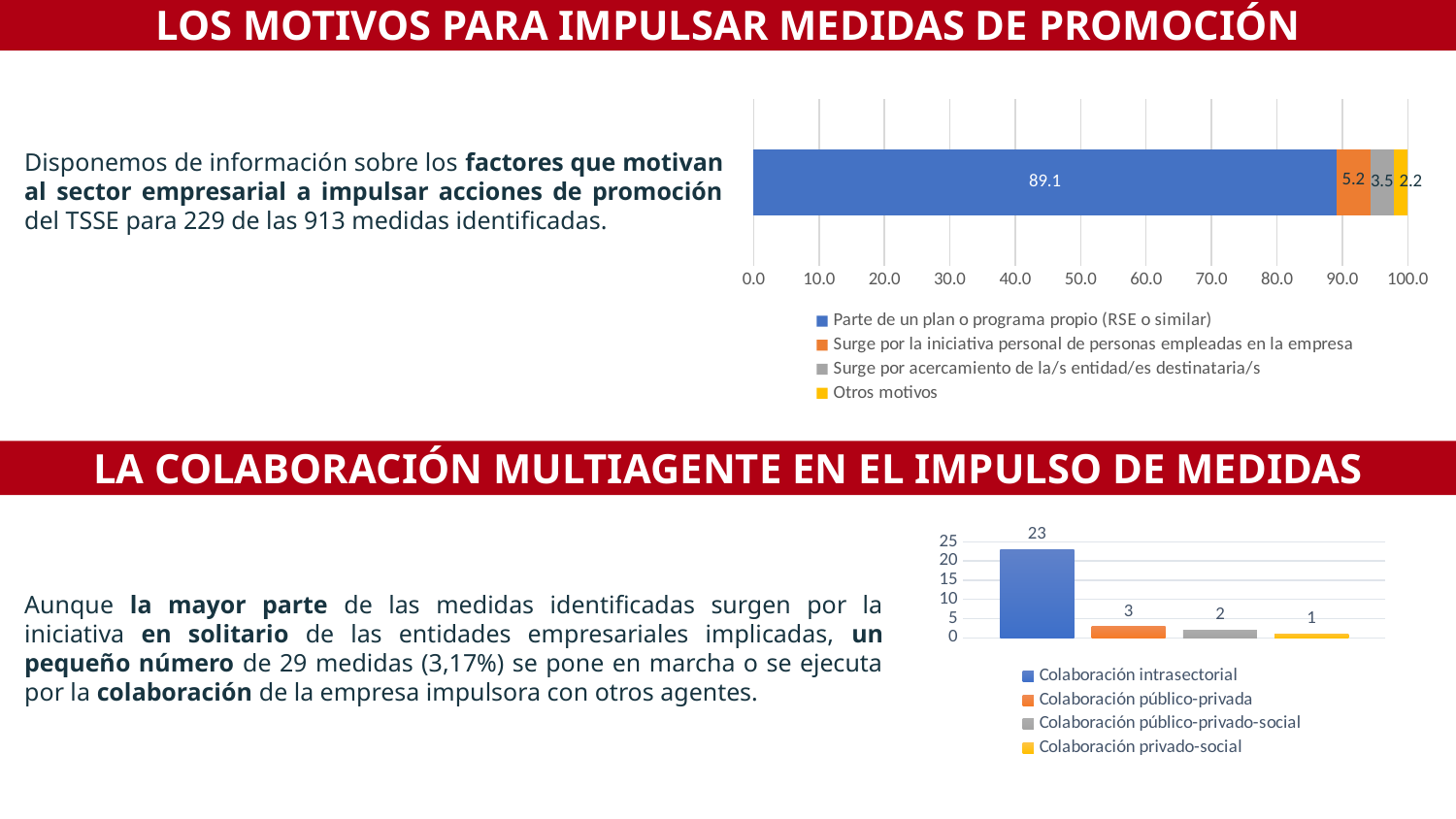
In the bottom chart, which is larger: 'Colaboración público-privada' or 'Colaboración público-privado-social'? Colaboración público-privada In the top chart, what is the value for 'Surge por la iniciativa personal de personas empleadas en la empresa'? 5.2 In the top chart, what is the difference between 'Surge por la iniciativa personal de personas empleadas en la empresa' and 'Surge por acercamiento de la/s entidad/es destinataria/s'? 1.7 In the bottom chart, what is the value for 'Colaboración intrasectorial'? 23 In the bottom chart, what is the difference between 'Colaboración intrasectorial' and 'Colaboración público-privada'? 20 In the top chart, what is the value for 'Parte de un plan o programa propio (RSE o similar)'? 89.1 In the top chart, how many series does the legend list? 4 In the top chart, what is the total of the stacked bar? 100.0 In the bottom chart, which category has the lowest value? Colaboración privado-social What kind of chart is the top chart? Stacked bar chart In the top chart, what is the value for 'Otros motivos'? 2.2 In the bottom chart, how many bars are plotted? 4